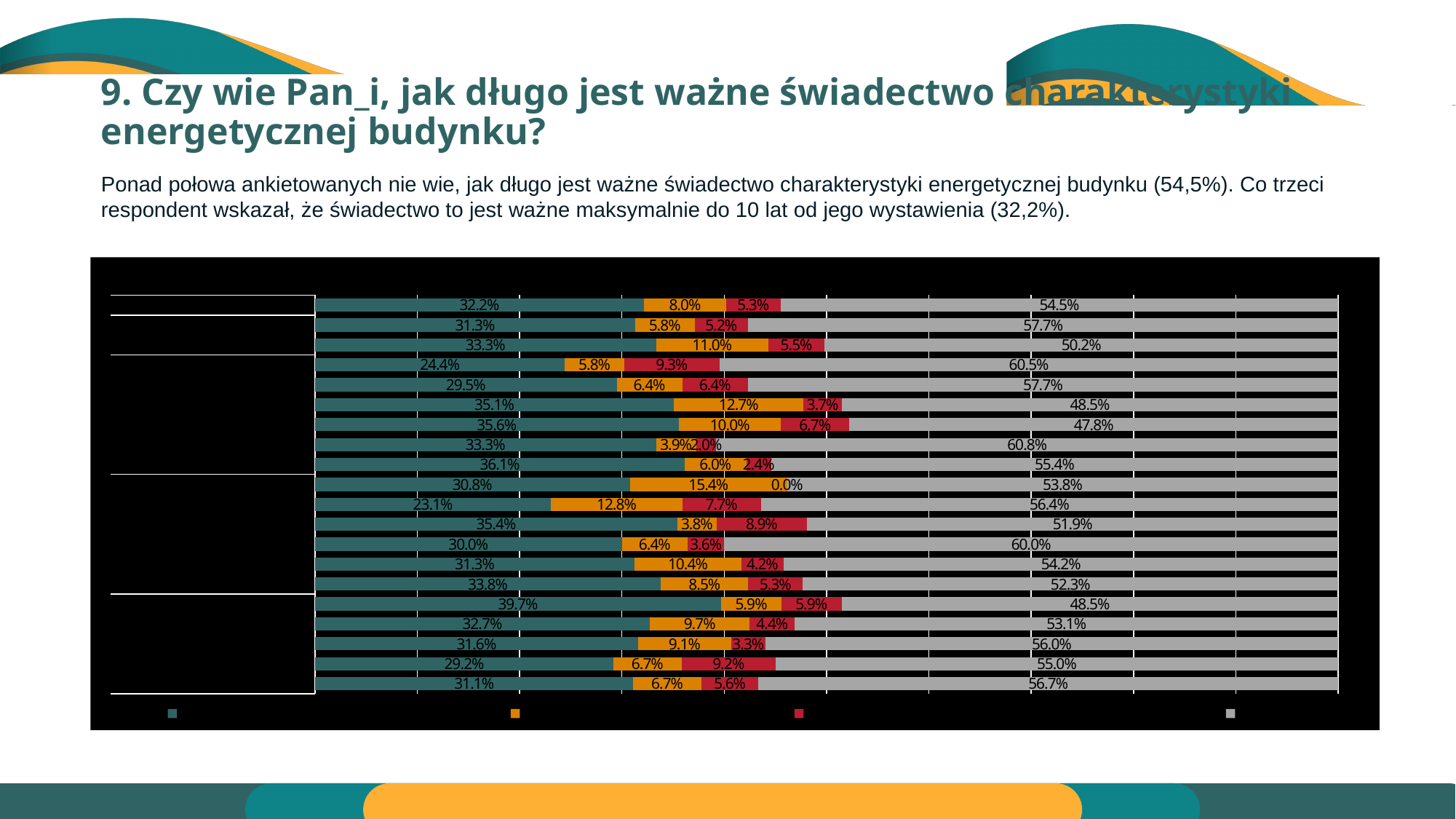
In the topmost bar, which is larger: the grey segment or the teal segment? grey segment How many series does the chart's legend list? 4 What is the difference between the grey segment (54.5%) and the teal segment (32.2%) in the topmost bar? 22.3% What is the total of the topmost stacked bar? 100.0% What kind of chart is shown on the slide? stacked bar chart What is the largest value shown for the grey (last) series across all bars? 60.8% What is the smallest value shown for the teal (first) series across all bars? 23.1% What is the largest value shown for the teal (first) series across all bars? 39.7% What is the value of the grey (last) segment in the topmost bar? 54.5% What is the value of the orange (second) segment in the topmost bar? 8.0% How many stacked bars does the chart contain? 20 What is the value of the teal (first) segment in the topmost bar? 32.2%